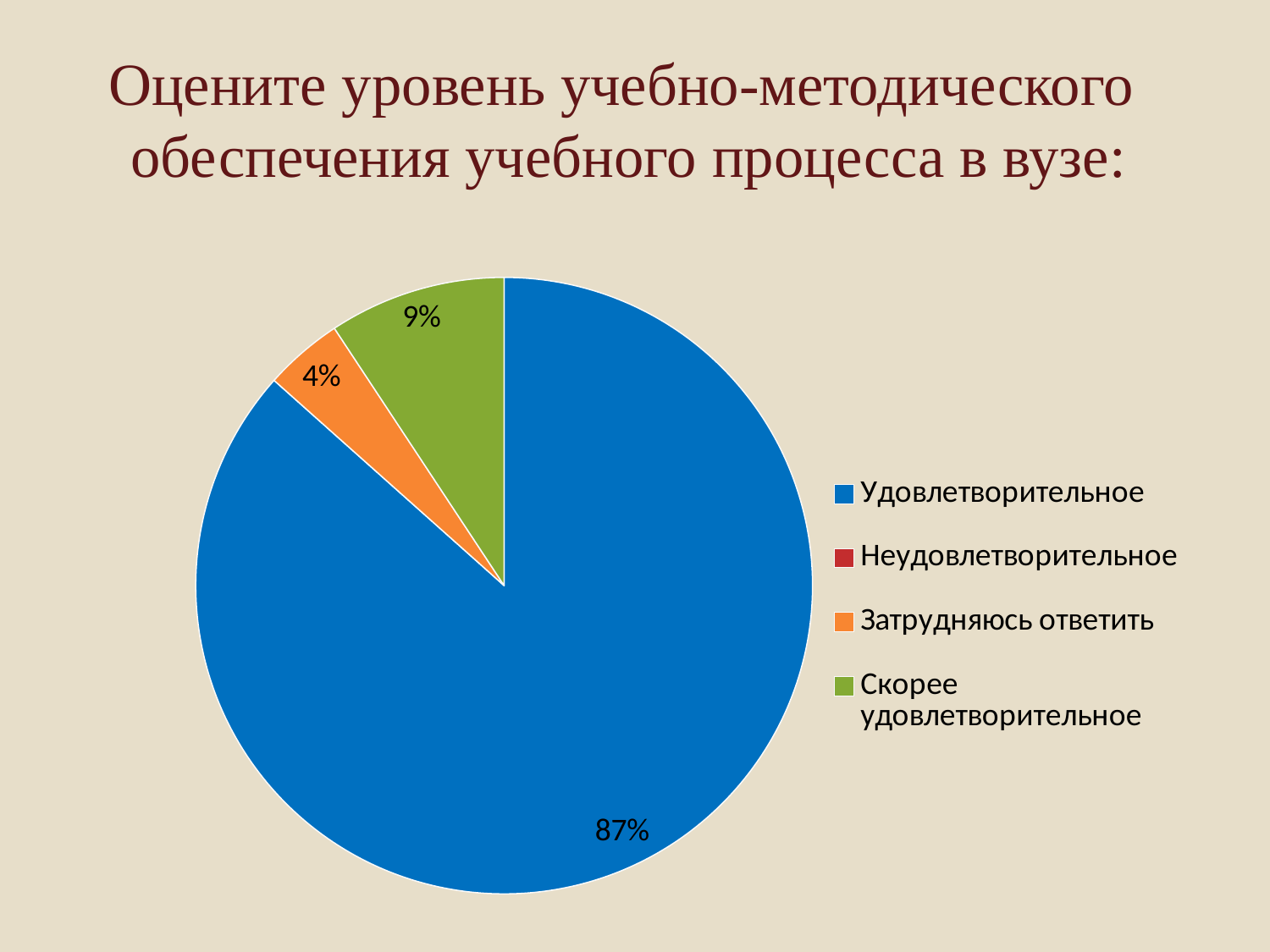
What percentage of the pie is labelled Удовлетворительное? 87% What percentage of the pie is labelled Затрудняюсь ответить? 4% What is the difference in percentage points between the Скорее удовлетворительное slice and the Затрудняюсь ответить slice? 5 percentage points What is the title of the slide? Оцените уровень учебно-методического обеспечения учебного процесса в вузе: Which slice is larger: Скорее удовлетворительное or Затрудняюсь ответить? Скорее удовлетворительное How many categories does the legend list? 4 What kind of chart is shown on the slide? Pie chart What share of the pie does the Удовлетворительное slice take? 87% Which category has the largest slice of the pie? Удовлетворительное What percentage of the pie is labelled Скорее удовлетворительное? 9% What is the difference in percentage points between the Удовлетворительное slice and the Скорее удовлетворительное slice? 78 percentage points What colour is the Затрудняюсь ответить slice? Orange